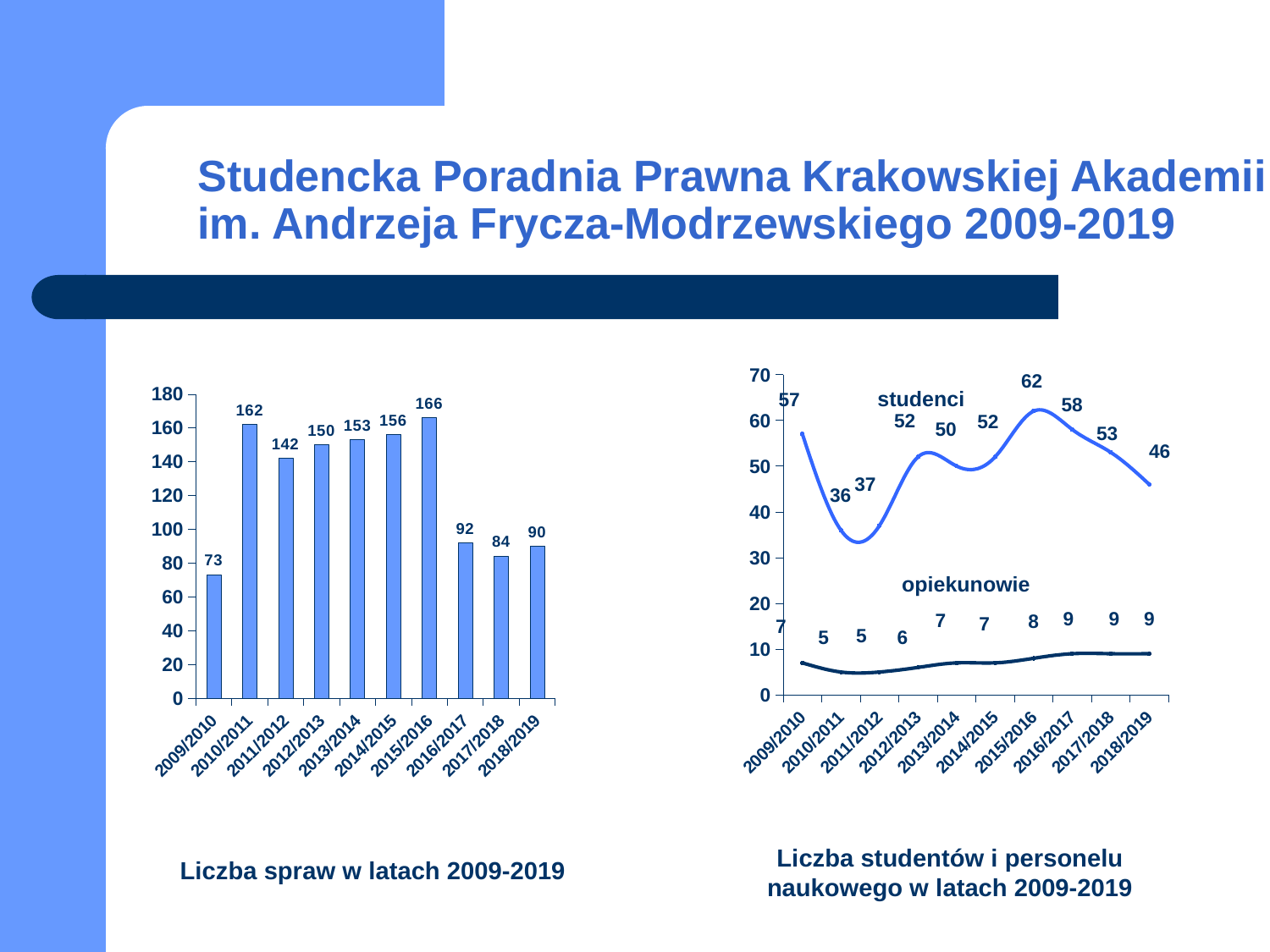
What type of chart is 'Liczba spraw w latach 2009-2019'? bar chart In the chart 'Liczba spraw w latach 2009-2019', which year has the lowest value? 2009/2010 In the chart 'Liczba spraw w latach 2009-2019', what is the value for 2015/2016? 166 In the chart 'Liczba studentów i personelu naukowego w latach 2009-2019', which series is larger in 2012/2013, studenci or opiekunowie? studenci In the chart 'Liczba studentów i personelu naukowego w latach 2009-2019', what is the value for opiekunowie in 2018/2019? 9 In the chart 'Liczba spraw w latach 2009-2019', which year has the highest value? 2015/2016 In the chart 'Liczba spraw w latach 2009-2019', how many years are shown on the x axis? 10 In the chart 'Liczba spraw w latach 2009-2019', what is the difference between the values for 2010/2011 and 2009/2010? 89 In the chart 'Liczba studentów i personelu naukowego w latach 2009-2019', in which year is the studenci value lowest? 2010/2011 In the chart 'Liczba studentów i personelu naukowego w latach 2009-2019', what is the difference between studenci and opiekunowie in 2009/2010? 50 In the chart 'Liczba studentów i personelu naukowego w latach 2009-2019', what is the value for studenci in 2015/2016? 62 What type of chart is 'Liczba studentów i personelu naukowego w latach 2009-2019'? line chart